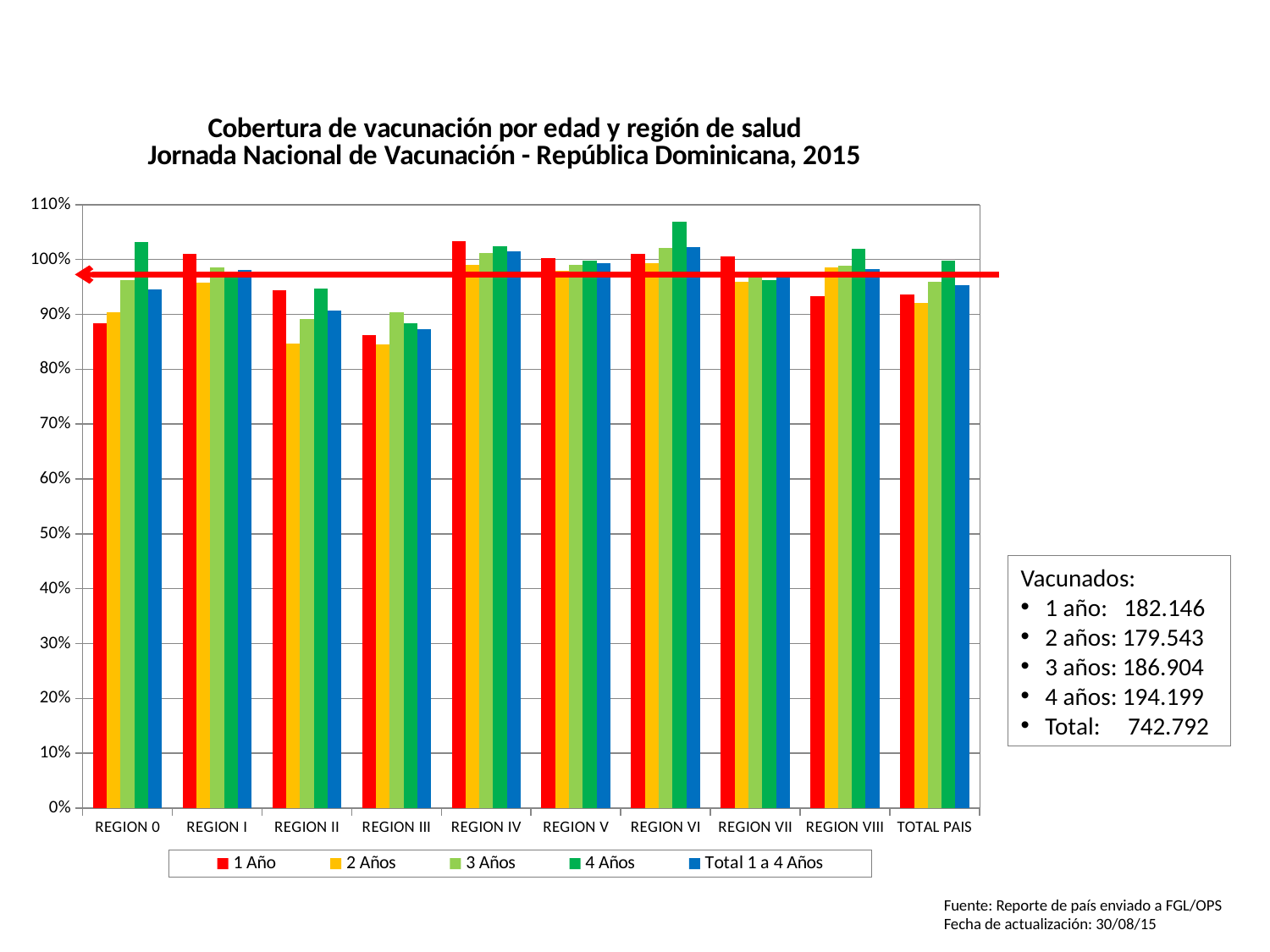
Which is larger, the 1 Año value for REGION 0 or the 1 Año value for REGION I? REGION I Which region has the highest value for 4 Años? REGION VI Which is larger, the 2 Años value for REGION III or the 2 Años value for REGION IV? REGION IV Is the value of 4 Años for REGION VI greater or less than 100%? greater Is the value of Total 1 a 4 Años for REGION III greater or less than 90%? less Is the value of 2 Años for REGION II greater or less than 90%? less Which region has the lowest value for Total 1 a 4 Años? REGION III Which series in the legend is shown in blue? Total 1 a 4 Años How many series does the chart legend list? 5 How many categories are shown along the x axis of the chart? 10 What kind of chart is shown on the slide? bar chart